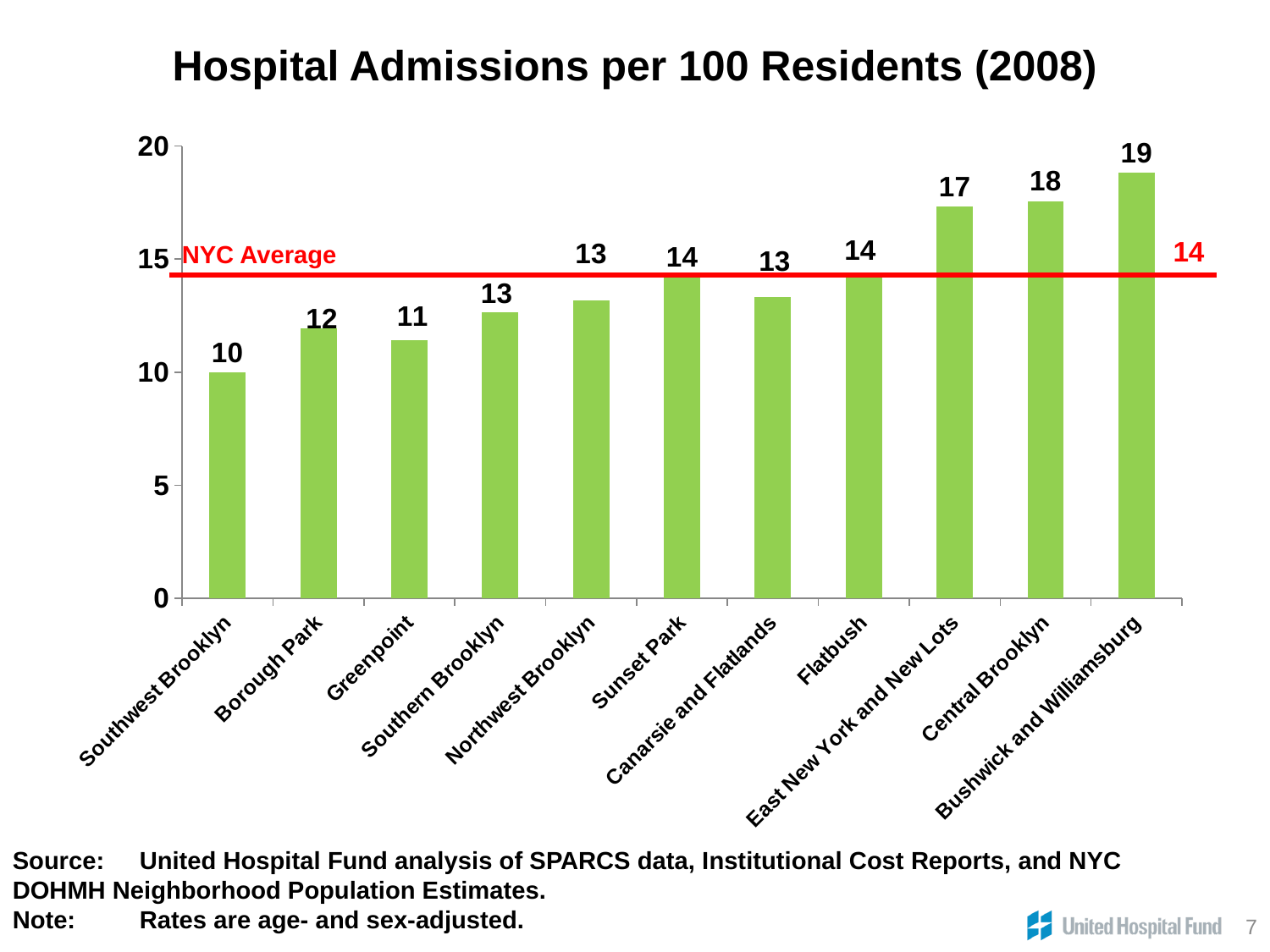
Which neighborhood has the highest hospital admissions per 100 residents? Bushwick and Williamsburg Which has a higher value, Borough Park or Greenpoint? Borough Park Is the value for Greenpoint greater or less than 15? less What is the hospital admissions rate per 100 residents for Southwest Brooklyn? 10 What is the NYC Average value shown on the chart? 14 How many neighborhoods are shown on the chart? 11 What is the difference between the values for Bushwick and Williamsburg and Southwest Brooklyn? 9 What type of chart is shown on the slide? Bar chart What is the value shown for East New York and New Lots? 17 What is the value shown for Central Brooklyn? 18 Which neighborhood has the lowest hospital admissions per 100 residents? Southwest Brooklyn Do the values generally rise or fall from left to right across the neighborhoods? Rise